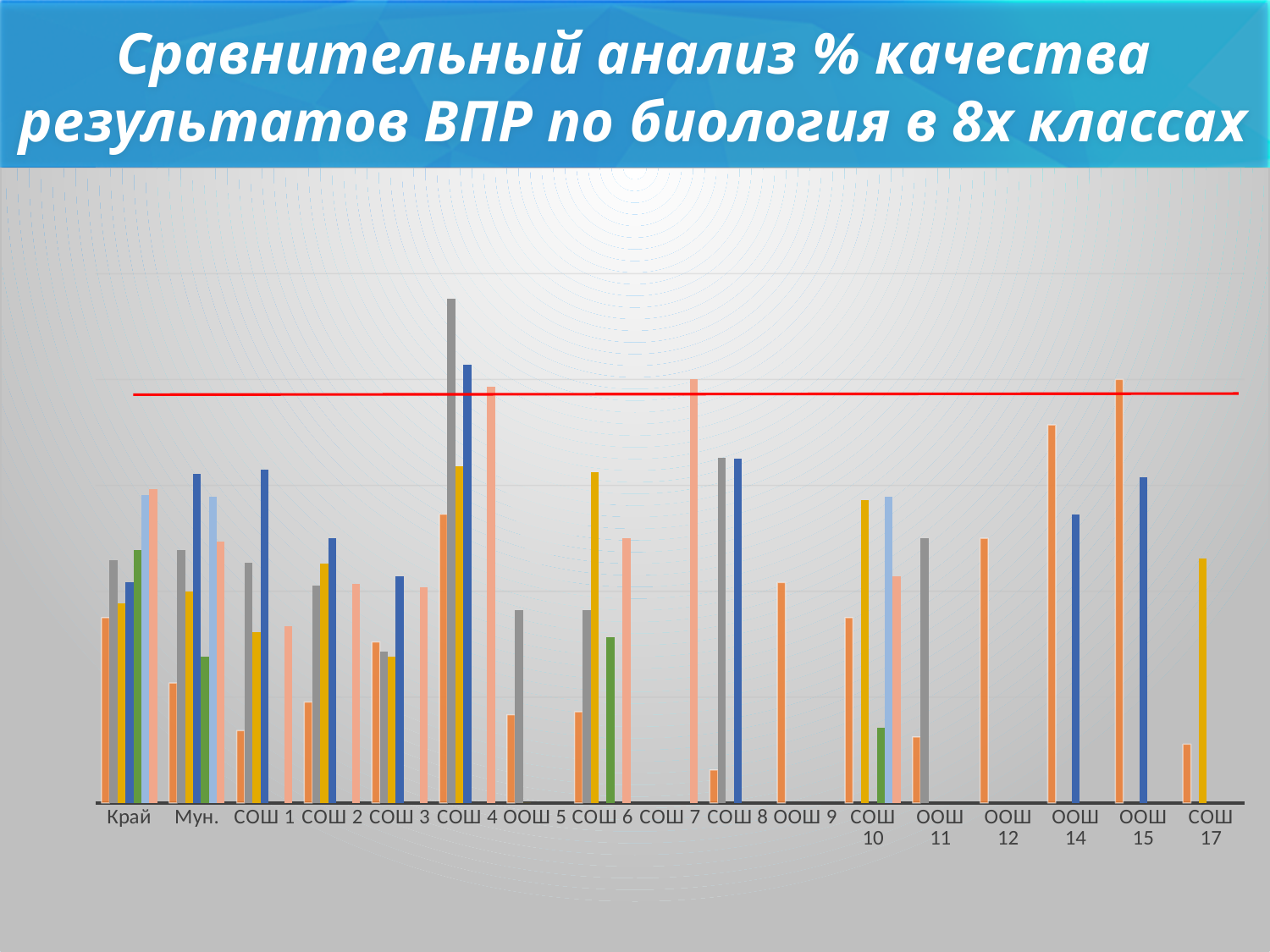
Which category has a taller tallest bar, ООШ 14 or ООШ 15? ООШ 15 Which category contains the shortest bar in the chart? СОШ 8 Which category has a taller tallest bar, СОШ 1 or СОШ 3? СОШ 1 How many categories have at least one bar rising above the red horizontal line? 3 What colour is the horizontal reference line drawn across the chart? Red What type of chart is shown on the slide? Bar chart How many categories are shown along the x axis of the chart? 17 Which category contains the tallest bar in the chart? СОШ 4 Does the tallest bar for СОШ 4 rise above the red horizontal line? Yes What is the title of the slide containing the chart? Сравнительный анализ % качества результатов ВПР по биология в 8х классах